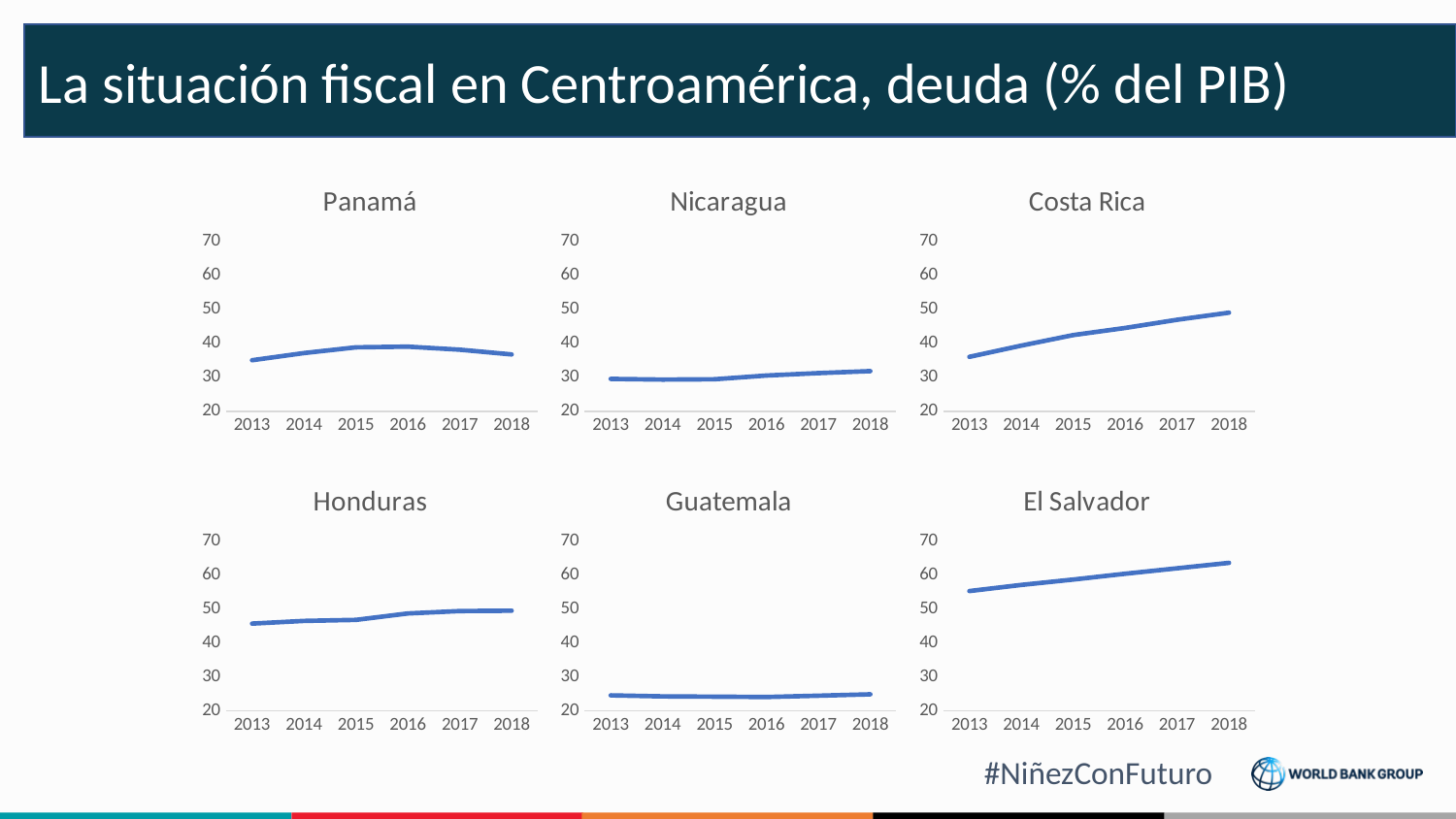
In the Costa Rica chart, how many years are plotted on the x axis? 6 What is the title of the chart in the top-right position of the slide? Costa Rica In the Honduras chart, is the value for 2013 greater or less than 40? greater In the El Salvador chart, do the values rise or fall from 2013 to 2018? rise What kind of chart is used for Panamá? line chart In the Costa Rica chart, do the values rise or fall from 2013 to 2018? rise In the El Salvador chart, is the value for 2018 greater or less than 60? greater Which is larger in 2018: the value in the El Salvador chart or the value in the Guatemala chart? El Salvador In the Guatemala chart, is the value for 2018 greater or less than 30? less How many charts are shown on the slide? 6